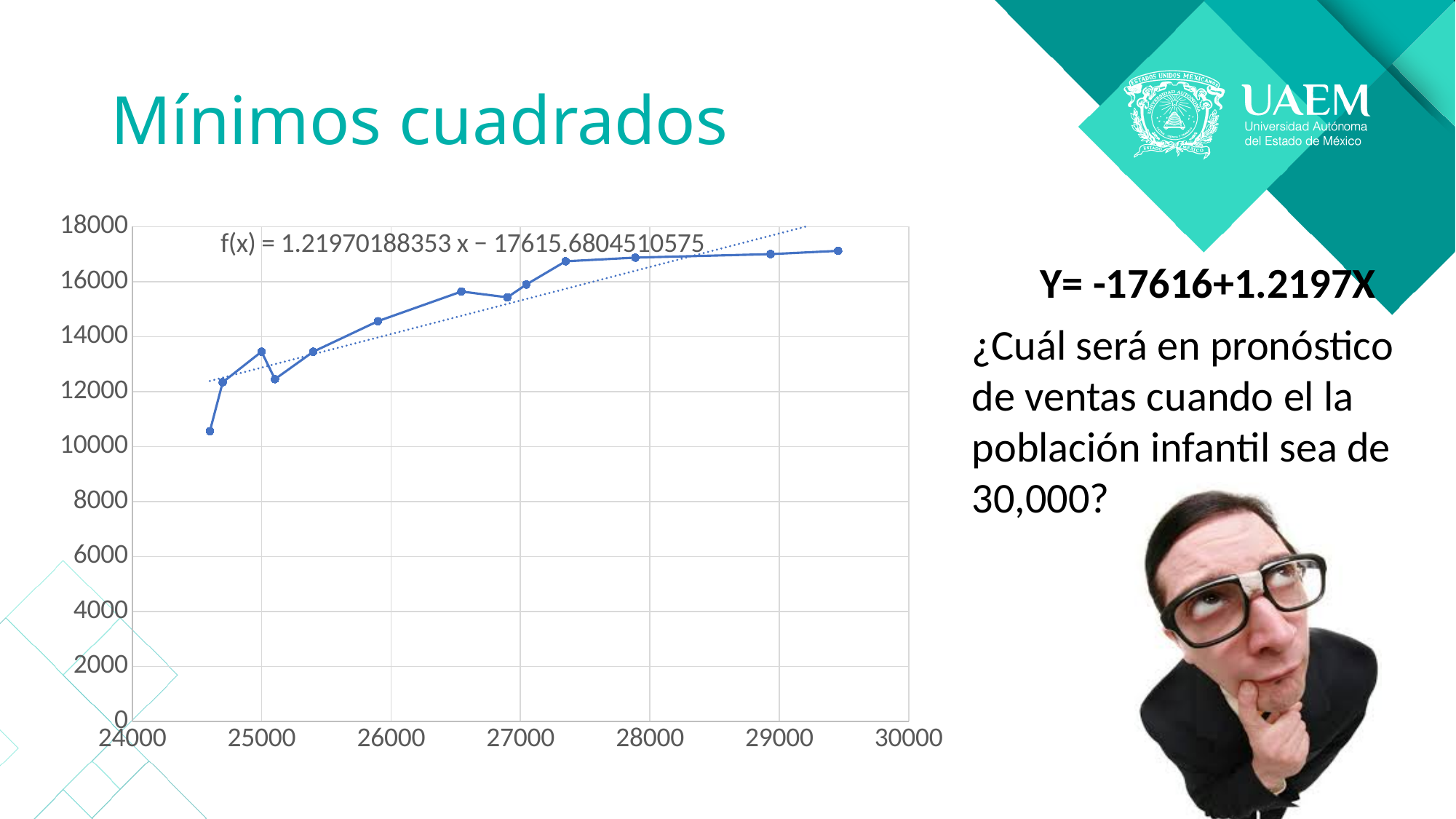
What is the trendline equation printed on the chart? f(x) = 1.21970188353 x − 17615.6804510575 Which data point has the lowest value, the leftmost or the rightmost? the leftmost Is the rightmost data point higher or lower than the leftmost data point? higher Is the value of the leftmost data point greater or less than 12000? less Do the plotted values generally rise or fall as x increases from 24000 to 30000? rise How many data points are plotted on the chart? 13 What kind of chart is shown on the slide? line chart What is the highest value shown on the y axis? 18000 Is the value of the leftmost data point greater or less than 10000? greater Is the value of the rightmost data point greater or less than 16000? greater